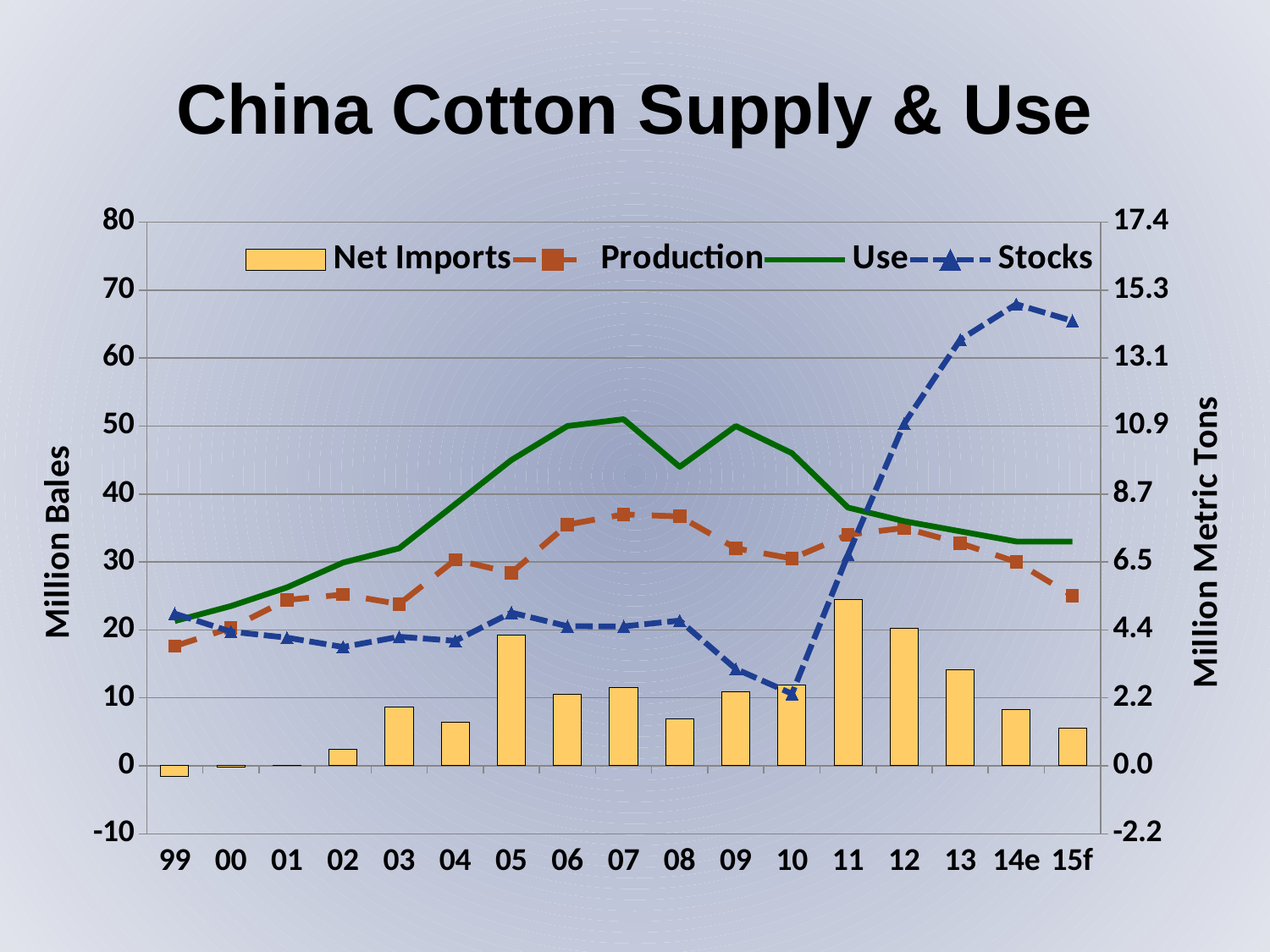
How many series does the legend list? 4 In which year are Net Imports highest? 11 Is the value for Stocks in 14e greater or less than 60 million bales? greater In which year are Net Imports lowest? 99 How many years are shown along the x axis? 17 Is the value for Production in 99 greater or less than 20 million bales? less What is the label on the right-hand vertical axis? Million Metric Tons What kind of chart is shown on the slide? A combination bar and line chart Is the value for Net Imports in 11 greater or less than 20 million bales? greater In which year are Stocks highest? 14e In 07, which is larger, Use or Production? Use Do Stocks rise or fall from 10 to 14e? Rise